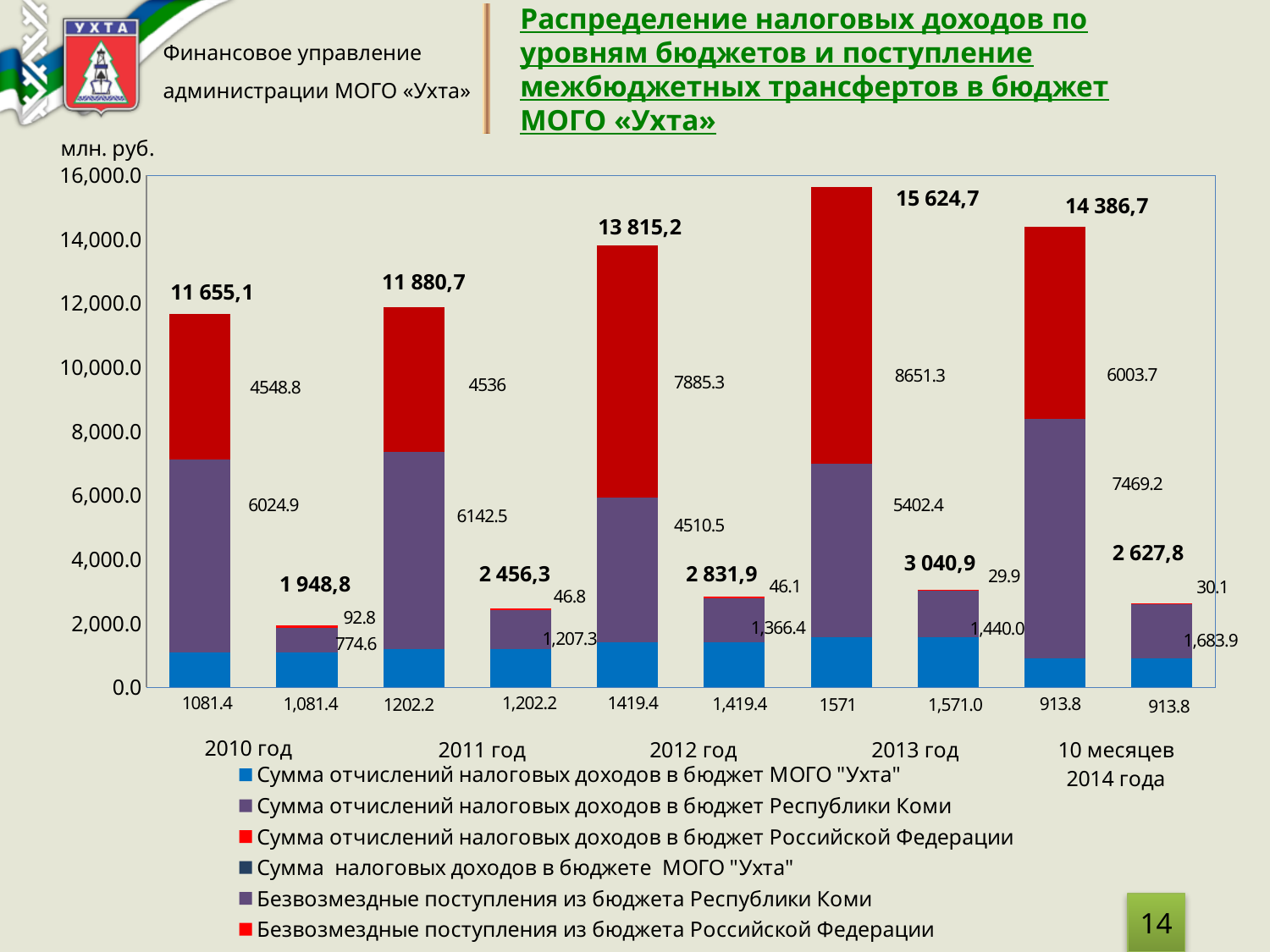
What is the value of 'Сумма отчислений налоговых доходов в бюджет Республики Коми' for 2011 год? 6142.5 What is the value of 'Сумма отчислений налоговых доходов в бюджет Российской Федерации' for 2013 год? 8651.3 What is the total labelled above the tall bar for 2013 год? 15 624,7 How many series does the legend list? 6 What is the total labelled above the short bar for 2012 год? 2 831,9 What kind of chart is shown on the slide? stacked bar chart What is the value of 'Безвозмездные поступления из бюджета Российской Федерации' for 2010 год? 92.8 Which period has the lowest total for the short (MOGO Ukhta budget) bar? 2010 год Which period has the highest total for the tall (tax revenue distribution) bar? 2013 год What is the difference between the tall-bar totals for 2013 год (15 624,7) and 2012 год (13 815,2)? 1 809,5 Is the tall bar for 2010 год greater or less than 12,000.0? less How many time periods (categories) are shown on the x axis? 5